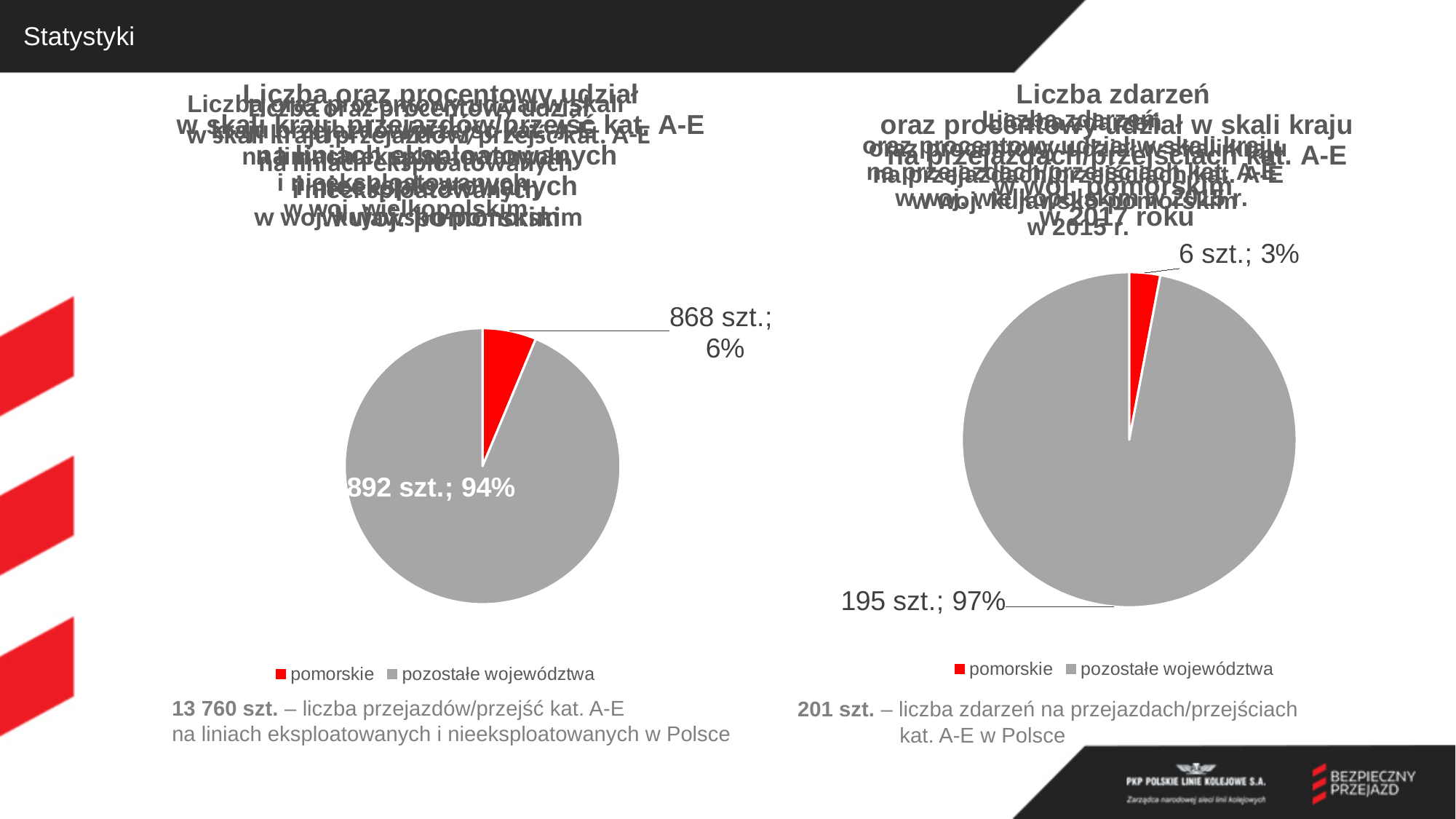
How many slices does the right pie chart have? 2 In the left pie chart, which category has the largest slice? pozostałe województwa What kind of chart is the left chart on the slide? pie chart In the right pie chart, what value is shown for pomorskie? 6 szt.; 3% In the right pie chart, what colour represents pomorskie? red In the right pie chart, which category has the smallest slice? pomorskie In the right pie chart, what value is shown for pozostałe województwa? 195 szt.; 97% In the right pie chart, what is the total number of szt. across both slices? 201 szt. In the right pie chart, what is the difference in szt. between pozostałe województwa and pomorskie? 189 szt. How many entries does the legend of the left pie chart list? 2 In the left pie chart, what share of the pie does pozostałe województwa have? 94% In the left pie chart, what value is shown for pomorskie? 868 szt.; 6%